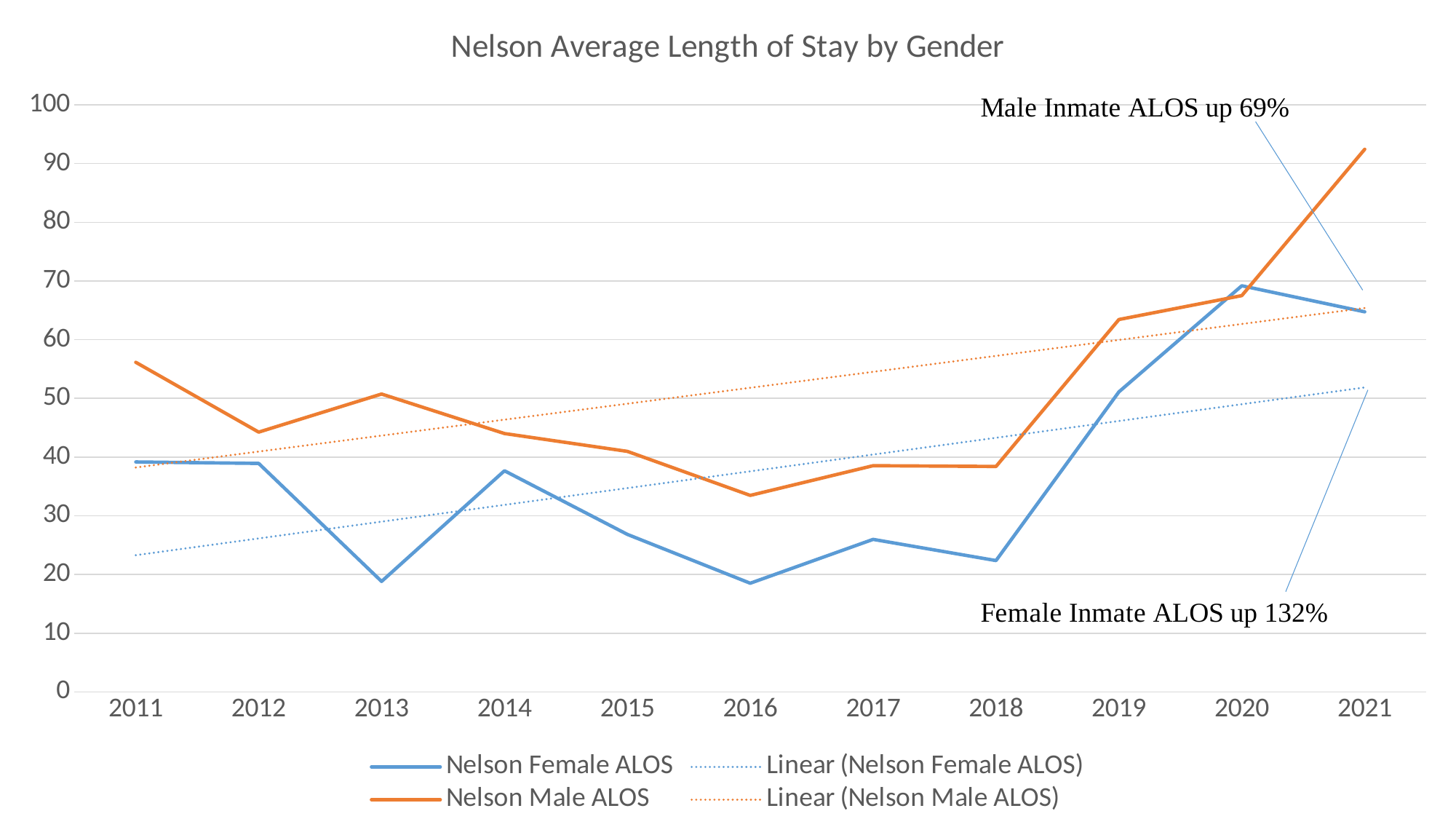
How many series does the legend list? 4 According to the annotation on the chart, by what percentage is Female Inmate ALOS up? 132% Does the Nelson Male ALOS rise or fall from 2018 to 2021? rise Is the Nelson Male ALOS value for 2016 greater or less than 40? less Is the Nelson Female ALOS value for 2019 greater or less than 40? greater What is the title of the chart? Nelson Average Length of Stay by Gender In which year is the Nelson Male ALOS highest? 2021 How many years are shown on the x axis? 11 Is the Nelson Female ALOS value for 2013 greater or less than 30? less Which is larger in 2011, the Nelson Male ALOS or the Nelson Female ALOS? Nelson Male ALOS What kind of chart is shown on the slide? line chart